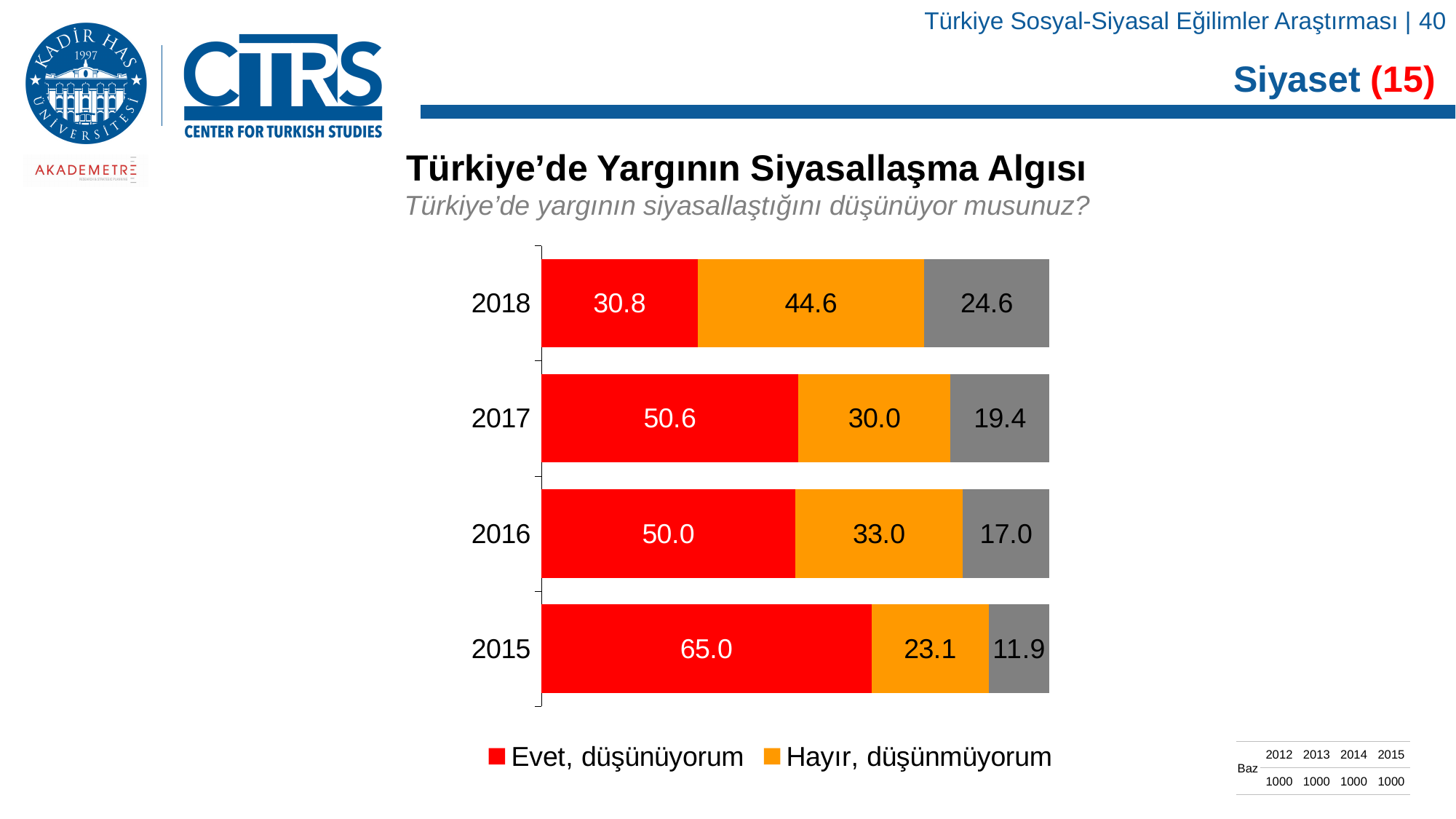
What is the total of the stacked bar for 2017? 100.0 In which year is the "Evet, düşünüyorum" value highest? 2015 What type of chart is shown on the slide? Stacked bar chart In which year is the "Evet, düşünüyorum" value lowest? 2018 How many series does the legend list? 2 What is the difference between the "Evet, düşünüyorum" values for 2015 and 2018? 34.2 What is the value for "Hayır, düşünmüyorum" in 2015? 23.1 How many years are shown on the chart? 4 In which year is the "Hayır, düşünmüyorum" value highest? 2018 Which is larger in 2016: "Evet, düşünüyorum" or "Hayır, düşünmüyorum"? Evet, düşünüyorum What is the value of the gray segment for 2017? 19.4 What is the value for "Evet, düşünüyorum" in 2018? 30.8